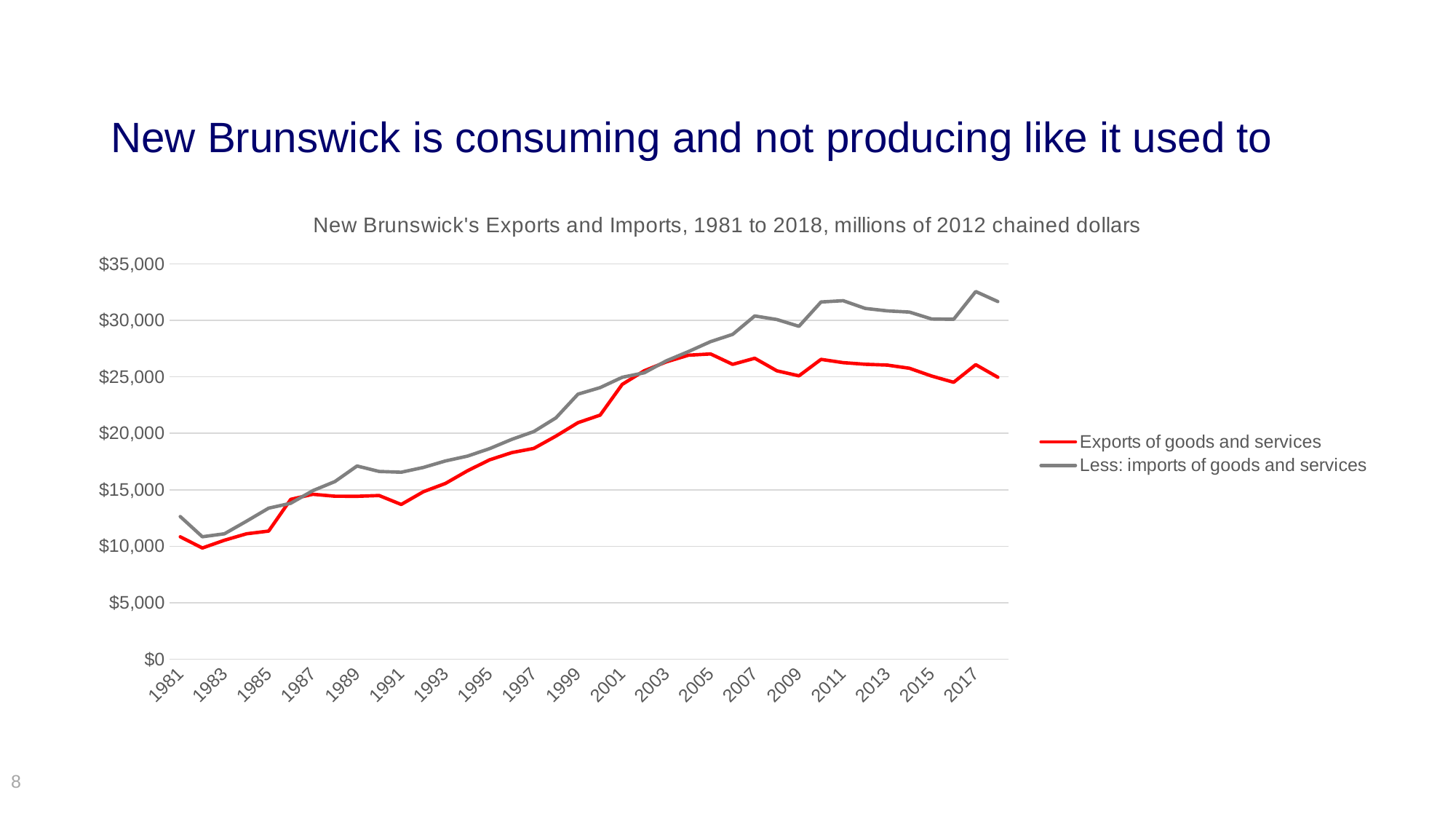
Which series reaches the highest value on the chart? Less: imports of goods and services Which series is drawn in red? Exports of goods and services In 2011, which is larger: exports of goods and services or imports of goods and services? imports of goods and services How many series does the legend list? 2 What is the title of the chart? New Brunswick's Exports and Imports, 1981 to 2018, millions of 2012 chained dollars From 1981 to 2018, do imports of goods and services generally rise or fall? rise Is the value for imports of goods and services in 2017 greater or less than $30,000? greater Is the value for exports of goods and services in 2009 greater or less than $30,000? less What kind of chart is shown on the slide? line chart In which year are exports of goods and services at their lowest? 1982 Is the value for imports of goods and services in 1989 greater or less than $15,000? greater